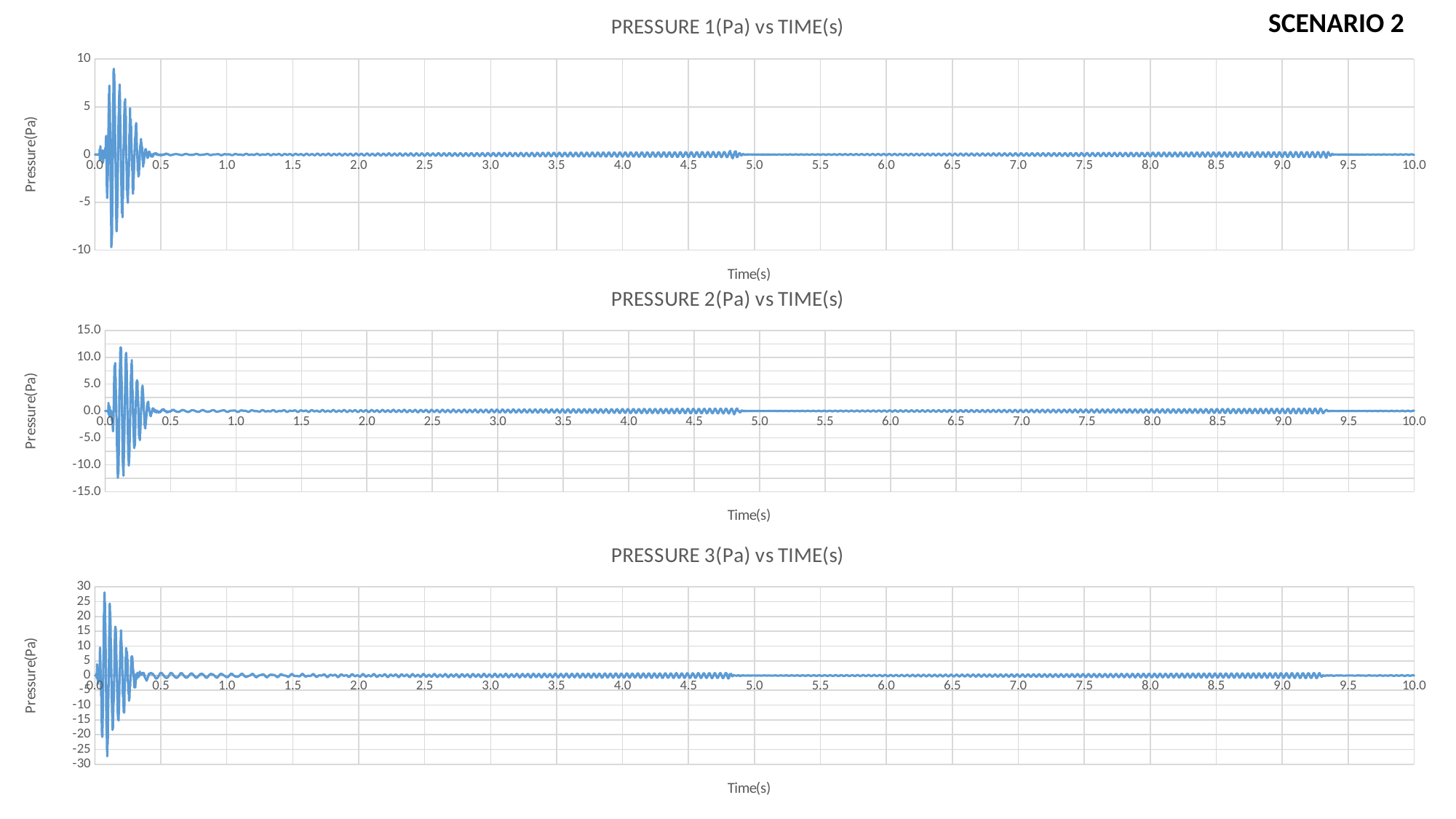
In 'PRESSURE 3(Pa) vs TIME(s)', is the lowest pressure greater or less than -20? less In 'PRESSURE 3(Pa) vs TIME(s)', is the peak pressure greater or less than 20? greater In 'PRESSURE 1(Pa) vs TIME(s)', does the amplitude of the oscillation increase or decrease as time goes from 0.2 s to 1.0 s? decrease What is the x-axis title of the 'PRESSURE 2(Pa) vs TIME(s)' chart? Time(s) How many charts are on the slide? 3 Which chart shows the larger peak pressure, 'PRESSURE 1(Pa) vs TIME(s)' or 'PRESSURE 3(Pa) vs TIME(s)'? PRESSURE 3(Pa) vs TIME(s) What is the y-axis title of the 'PRESSURE 3(Pa) vs TIME(s)' chart? Pressure(Pa) What kind of chart is 'PRESSURE 1(Pa) vs TIME(s)'? line chart In 'PRESSURE 1(Pa) vs TIME(s)', is the pressure at time 7.0 s greater or less than 5? less Which chart shows the smaller peak pressure, 'PRESSURE 2(Pa) vs TIME(s)' or 'PRESSURE 3(Pa) vs TIME(s)'? PRESSURE 2(Pa) vs TIME(s)